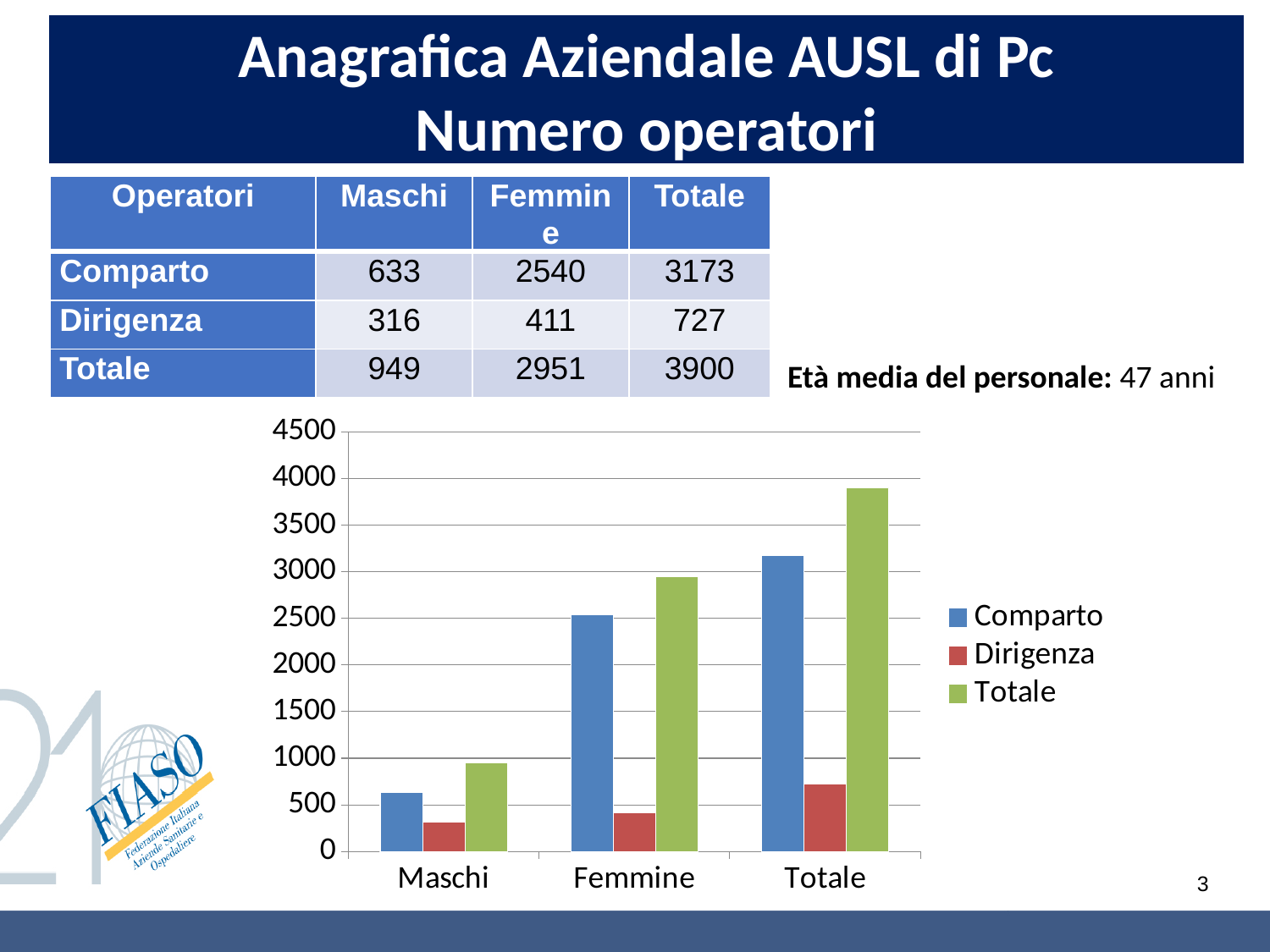
What kind of chart is shown on the slide? bar chart Is the Comparto value for Femmine greater or less than 2000? greater Which category has the highest Totale bar in the chart? Totale Do the Comparto values rise or fall from Maschi to Totale along the x axis? rise Which is larger in the chart: the Comparto bar for Femmine or the Comparto bar for Maschi? Femmine Is the Totale value for Maschi greater or less than 1000? less Is the Dirigenza value for Totale greater or less than 1000? less According to the slide, what is the Comparto value for Femmine? 2540 What colour are the Totale bars in the chart? green Which category has the lowest Dirigenza bar in the chart? Maschi How many categories are shown on the x axis of the chart? 3 How many series does the chart legend list? 3